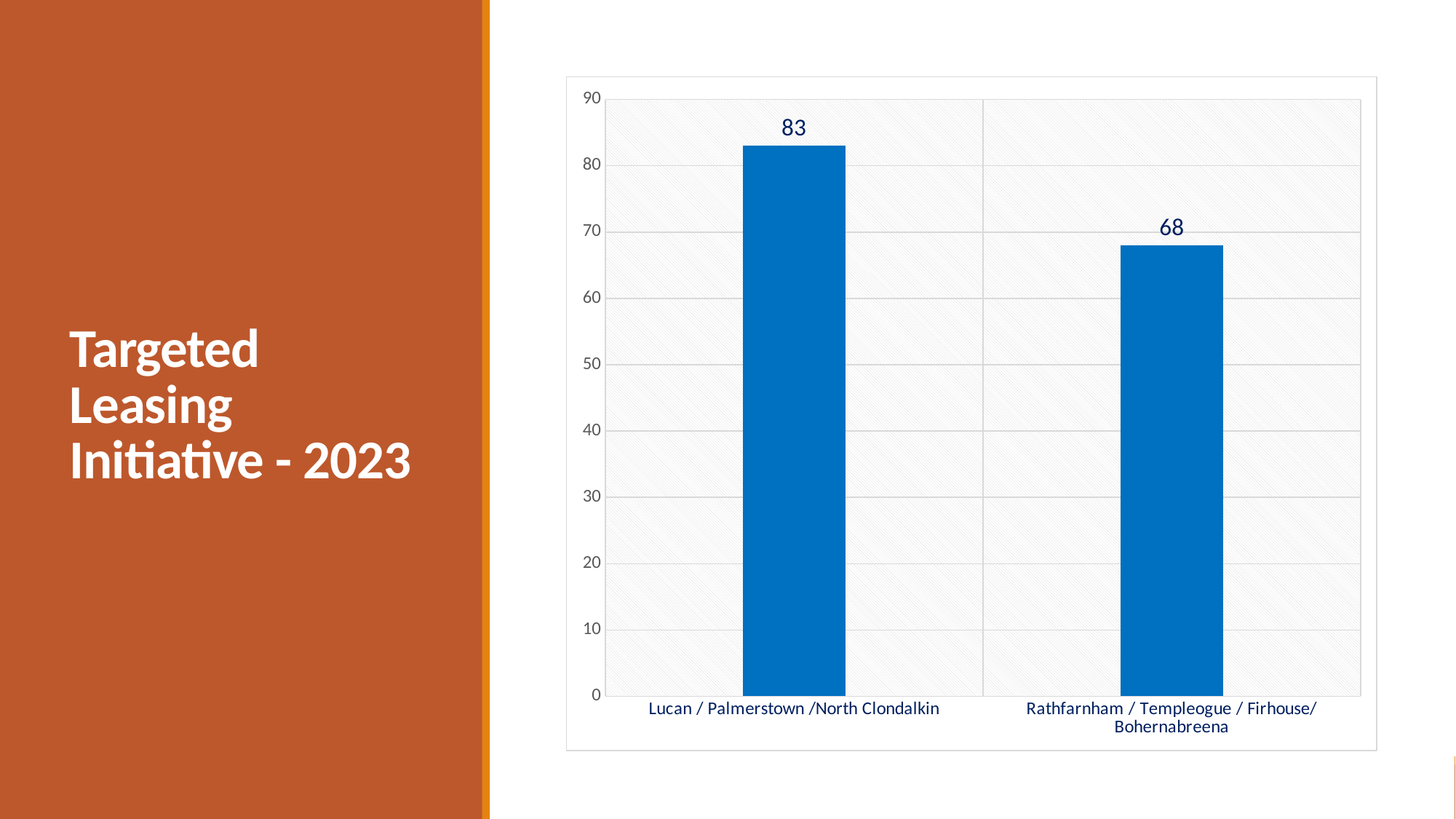
What is the difference between the values for Lucan / Palmerstown / North Clondalkin and Rathfarnham / Templeogue / Firhouse / Bohernabreena? 15 Is the value for Rathfarnham / Templeogue / Firhouse / Bohernabreena greater or less than 70? less Which category has the highest value? Lucan / Palmerstown / North Clondalkin Is the value for Lucan / Palmerstown / North Clondalkin greater or less than 80? greater Which category has the lowest value? Rathfarnham / Templeogue / Firhouse / Bohernabreena What is the maximum value shown on the vertical axis? 90 What is the value for Rathfarnham / Templeogue / Firhouse / Bohernabreena? 68 What is the value for Lucan / Palmerstown / North Clondalkin? 83 What kind of chart is shown on the slide? bar chart How many categories are shown on the chart? 2 Which is larger: the value for Lucan / Palmerstown / North Clondalkin or the value for Rathfarnham / Templeogue / Firhouse / Bohernabreena? Lucan / Palmerstown / North Clondalkin What is the title of the slide containing the chart? Targeted Leasing Initiative - 2023